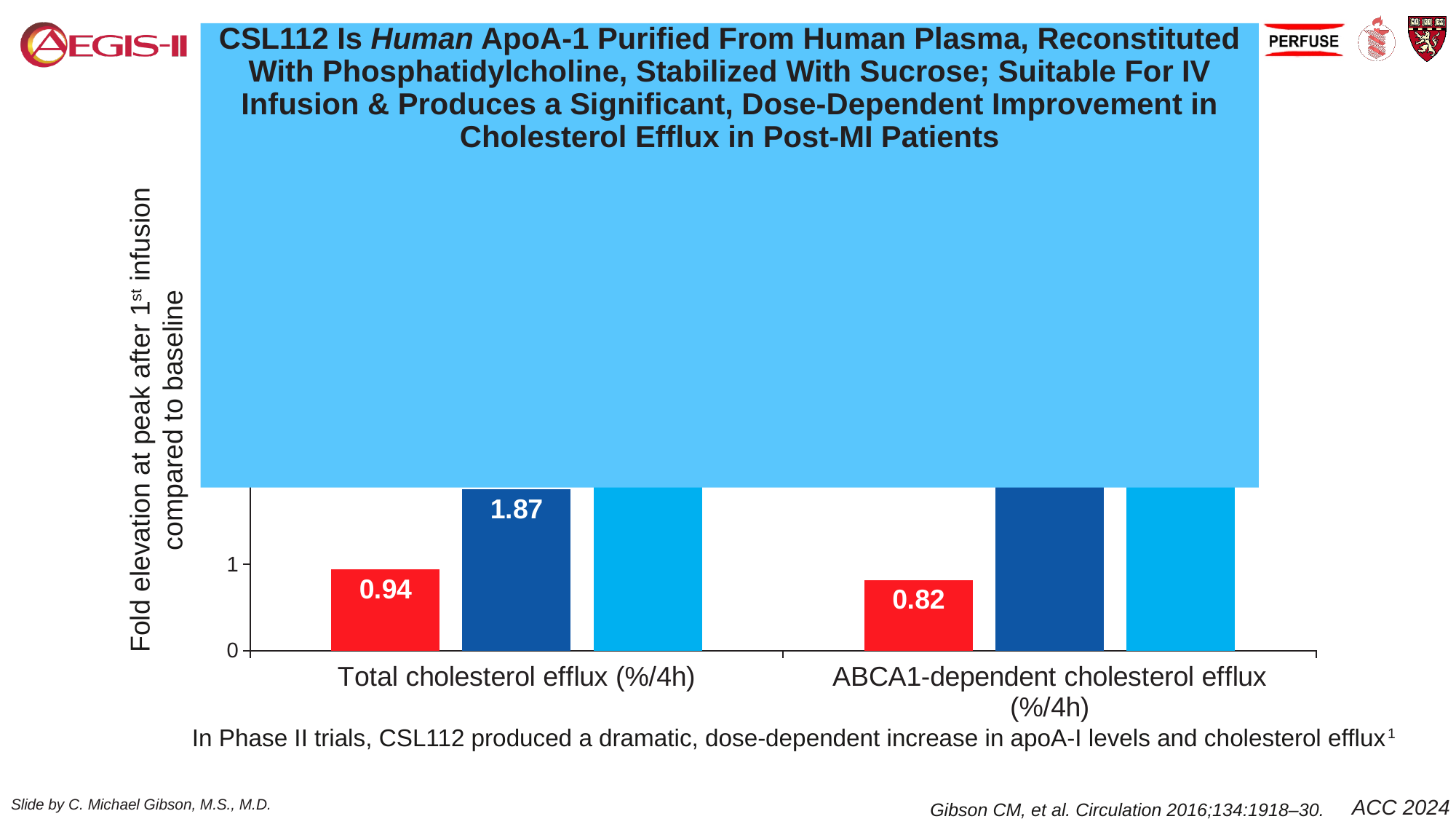
Which red bar is larger: Total cholesterol efflux (%/4h) or ABCA1-dependent cholesterol efflux (%/4h)? Total cholesterol efflux (%/4h) What kind of chart is shown on the slide? bar chart How many categories are shown on the x axis of the chart? 2 Is the value of the dark blue bar for Total cholesterol efflux (%/4h) greater or less than 1? greater What is the value of the red bar for ABCA1-dependent cholesterol efflux (%/4h)? 0.82 What is the value of the dark blue bar for Total cholesterol efflux (%/4h)? 1.87 What is the label of the y axis of the chart? Fold elevation at peak after 1st infusion compared to baseline Is the value of the red bar for ABCA1-dependent cholesterol efflux (%/4h) greater or less than 1? less For Total cholesterol efflux (%/4h), which bar is larger: the red bar or the dark blue bar? the dark blue bar What is the value of the red bar for Total cholesterol efflux (%/4h)? 0.94 What is the difference between the red bar values for Total cholesterol efflux (%/4h) and ABCA1-dependent cholesterol efflux (%/4h)? 0.12 For Total cholesterol efflux (%/4h), what is the difference between the dark blue bar and the red bar? 0.93